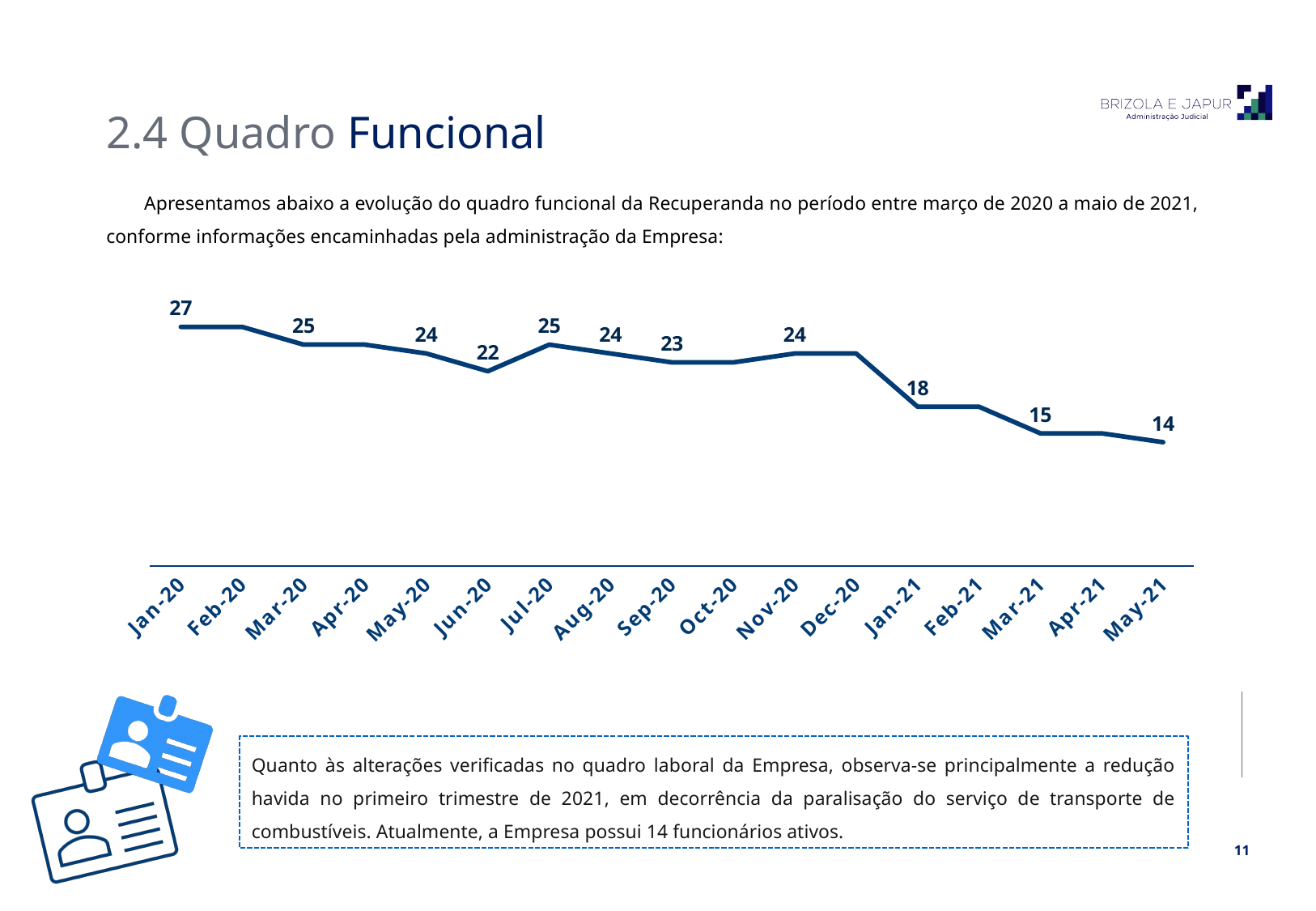
What is the difference between the values for Jan-20 and May-21? 13 Which month has the lowest value? May-21 What is the value for Sep-20? 23 What type of chart is shown on the slide? line chart Do the values generally rise or fall from Jan-20 to May-21? fall Which month has the highest value? Jan-20 What is the value for May-21? 14 How many months are shown on the x axis? 17 What is the value for Jun-20? 22 What is the value for Jan-20? 27 What is the value for Jan-21? 18 Which is larger, the value for Jul-20 or the value for Jan-21? Jul-20